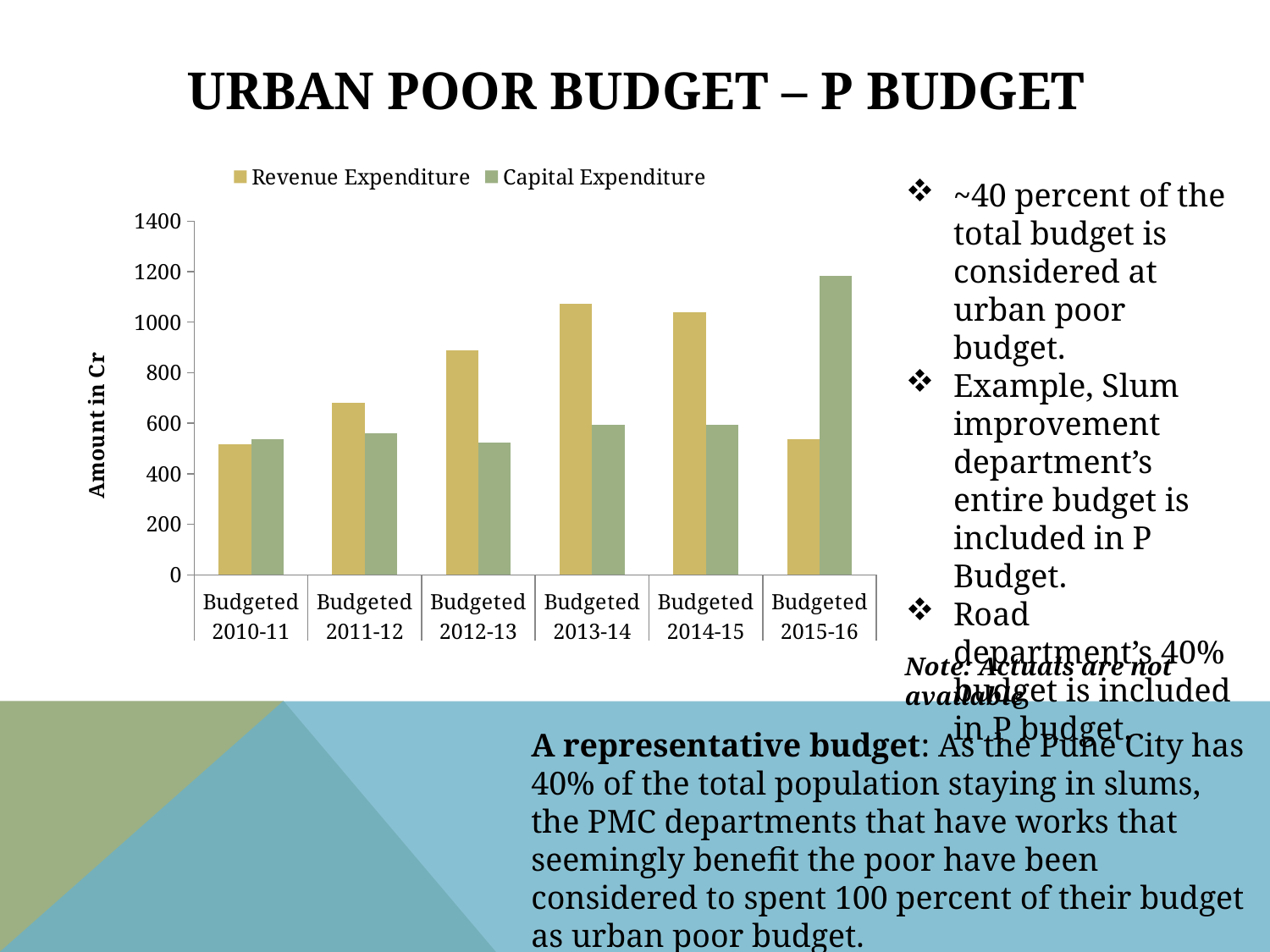
What is the title of the chart's vertical axis? Amount in Cr Is the Capital Expenditure for Budgeted 2010-11 greater or less than 400? greater What kind of chart is shown on the slide? bar chart For Budgeted 2015-16, which is larger: Revenue Expenditure or Capital Expenditure? Capital Expenditure Is the Revenue Expenditure for Budgeted 2013-14 greater or less than 1000? greater For Budgeted 2012-13, which is larger: Revenue Expenditure or Capital Expenditure? Revenue Expenditure Does Revenue Expenditure rise or fall from Budgeted 2010-11 to Budgeted 2013-14? rise Is the Revenue Expenditure for Budgeted 2012-13 greater or less than 800? greater How many budget years are shown on the x axis of the chart? 6 How many series does the chart legend list? 2 Which budget year has the highest Capital Expenditure? Budgeted 2015-16